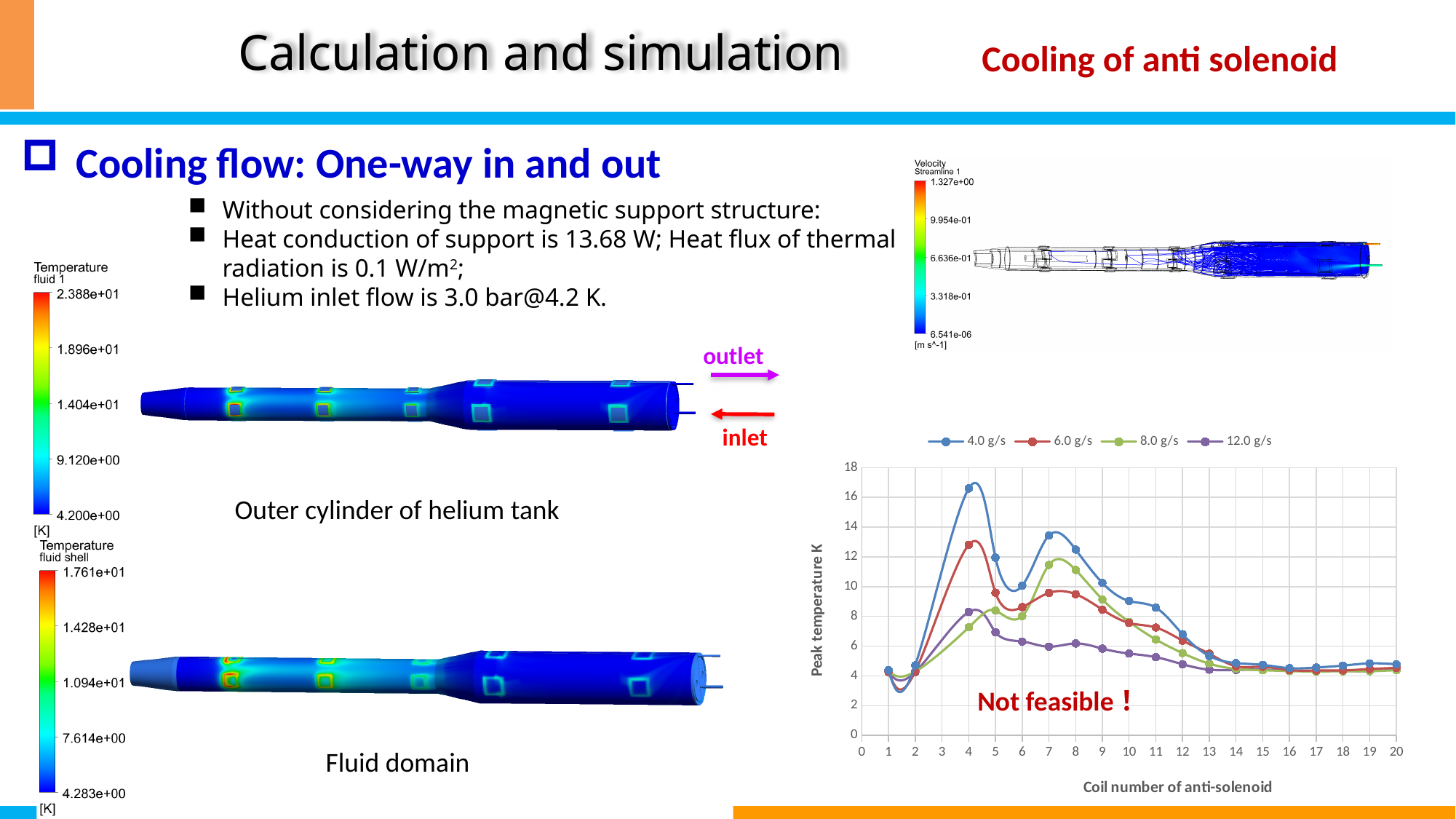
Is the value for the 6.0 g/s series at coil number 4 greater or less than 12? greater How many series does the legend of the peak temperature chart list? 4 What is the label of the x axis of the line chart? Coil number of anti-solenoid Does the 4.0 g/s series rise or fall from coil number 7 to coil number 13? fall Which series reaches the highest peak temperature in the chart? 4.0 g/s Is the value for the 4.0 g/s series at coil number 7 greater or less than 12? greater What is the label of the y axis of the line chart? Peak temperature K Is the value for the 12.0 g/s series at coil number 4 greater or less than 10? less Which series has the lowest value at coil number 7? 12.0 g/s At coil number 4, which series has the larger value: 4.0 g/s or 12.0 g/s? 4.0 g/s What kind of chart is the peak temperature versus coil number chart? line chart